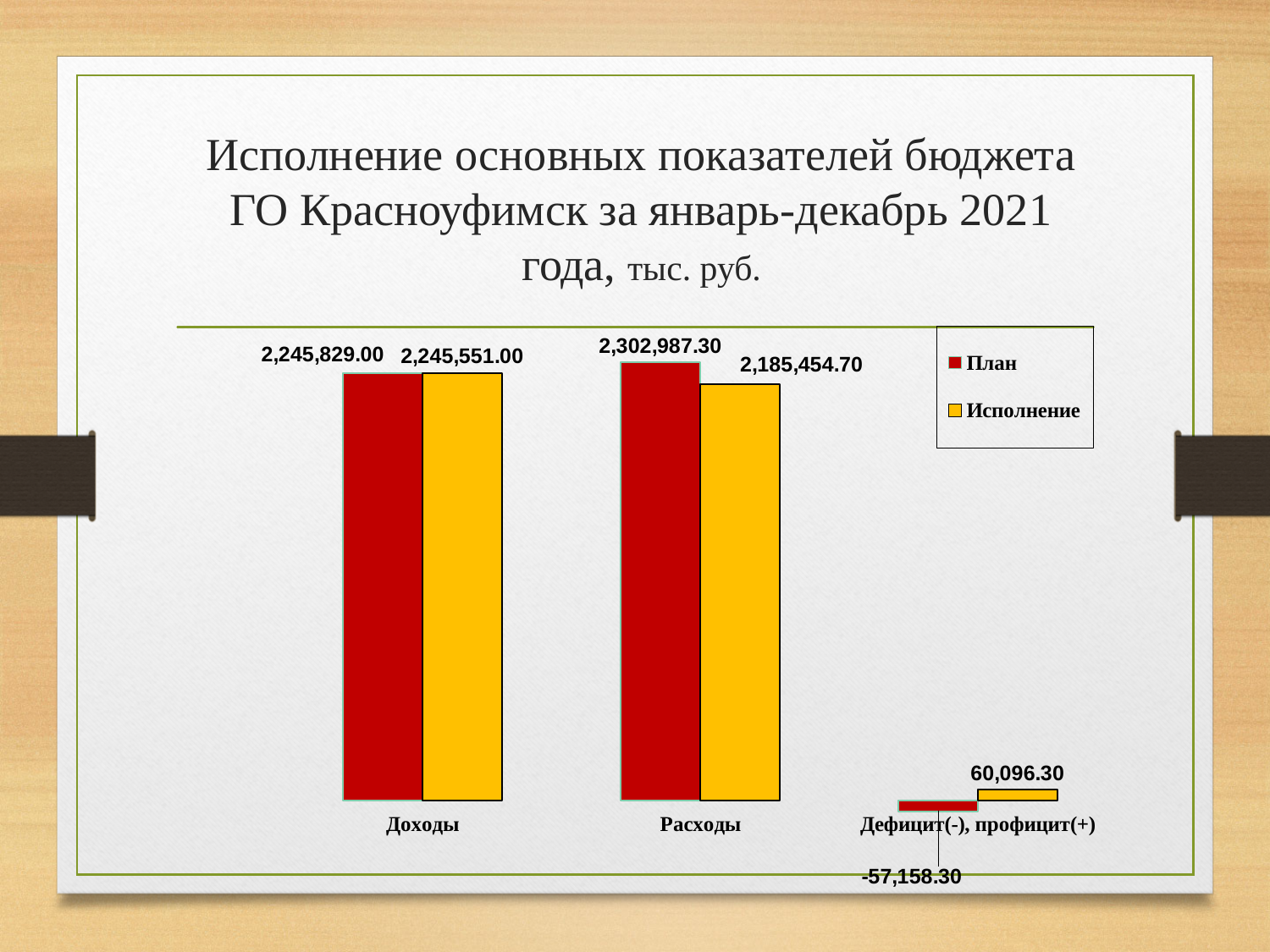
What is the difference between the План and Исполнение values for Расходы? 117,532.60 How many categories are shown on the x axis? 3 Which category has the highest План value? Расходы What is the Исполнение value for Расходы? 2,185,454.70 Which category has the lowest Исполнение value? Дефицит(-), профицит(+) What is the План value for Доходы? 2,245,829.00 Which is larger for Расходы, the План value or the Исполнение value? План What is the Исполнение value for Дефицит(-), профицит(+)? 60,096.30 What is the План value for Дефицит(-), профицит(+)? -57,158.30 What is the difference between the План and Исполнение values for Доходы? 278.00 What kind of chart is shown on the slide? Bar chart How many series does the legend list? 2